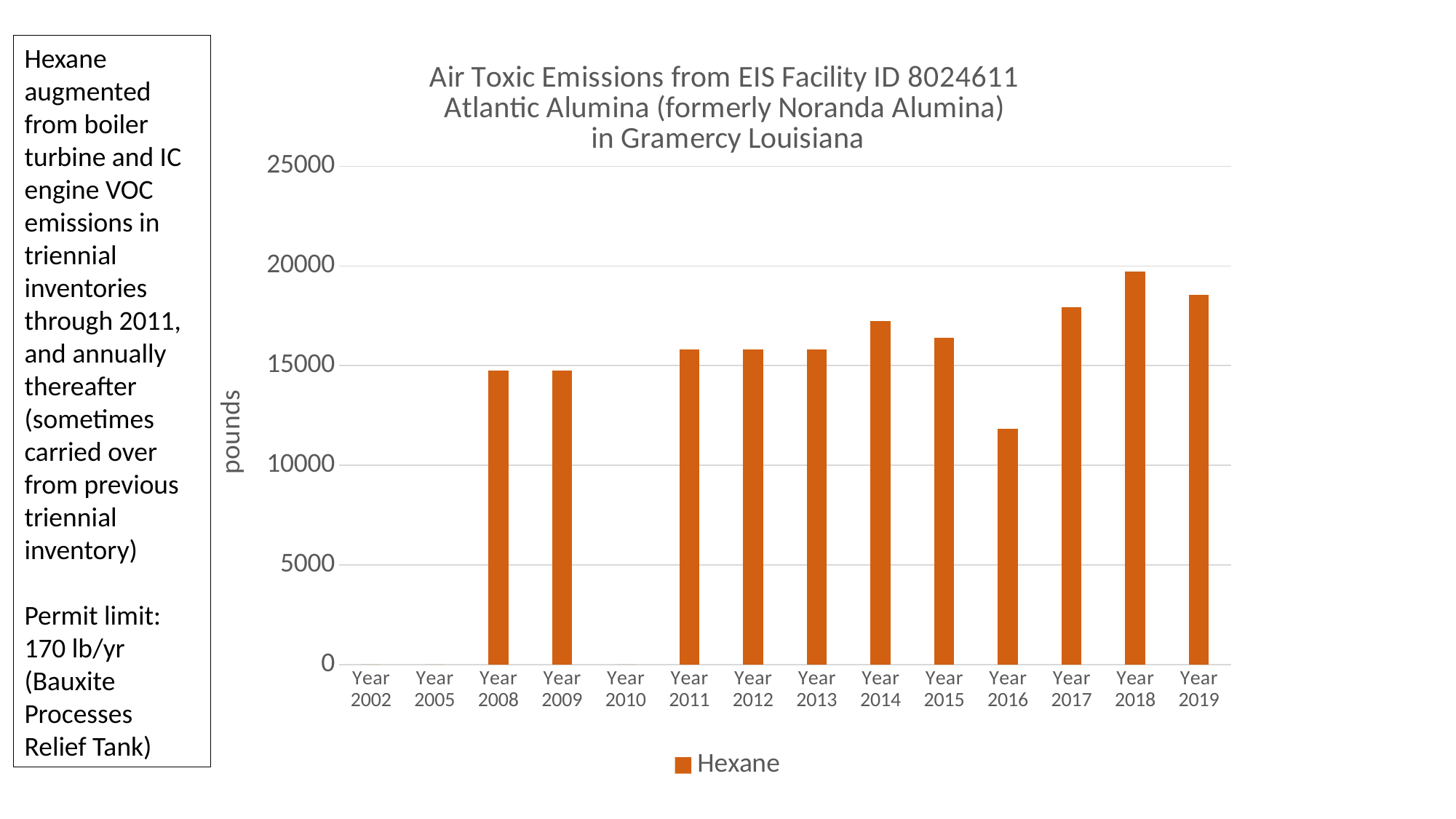
Is the value for Year 2018 greater or less than 20000? less How many series does the legend list? 1 What kind of chart is shown on the slide? bar chart What is the label on the vertical axis? pounds What is the name of the series shown in the legend? Hexane How many year categories are shown along the x axis? 14 Among the years with a visible bar, which year has the shortest bar? Year 2016 Which is larger, the value for Year 2014 or the value for Year 2015? Year 2014 Which year has the tallest bar? Year 2018 Do the values rise or fall from Year 2016 to Year 2018? rise Is the value for Year 2014 greater or less than 15000? greater Is the value for Year 2016 greater or less than 15000? less